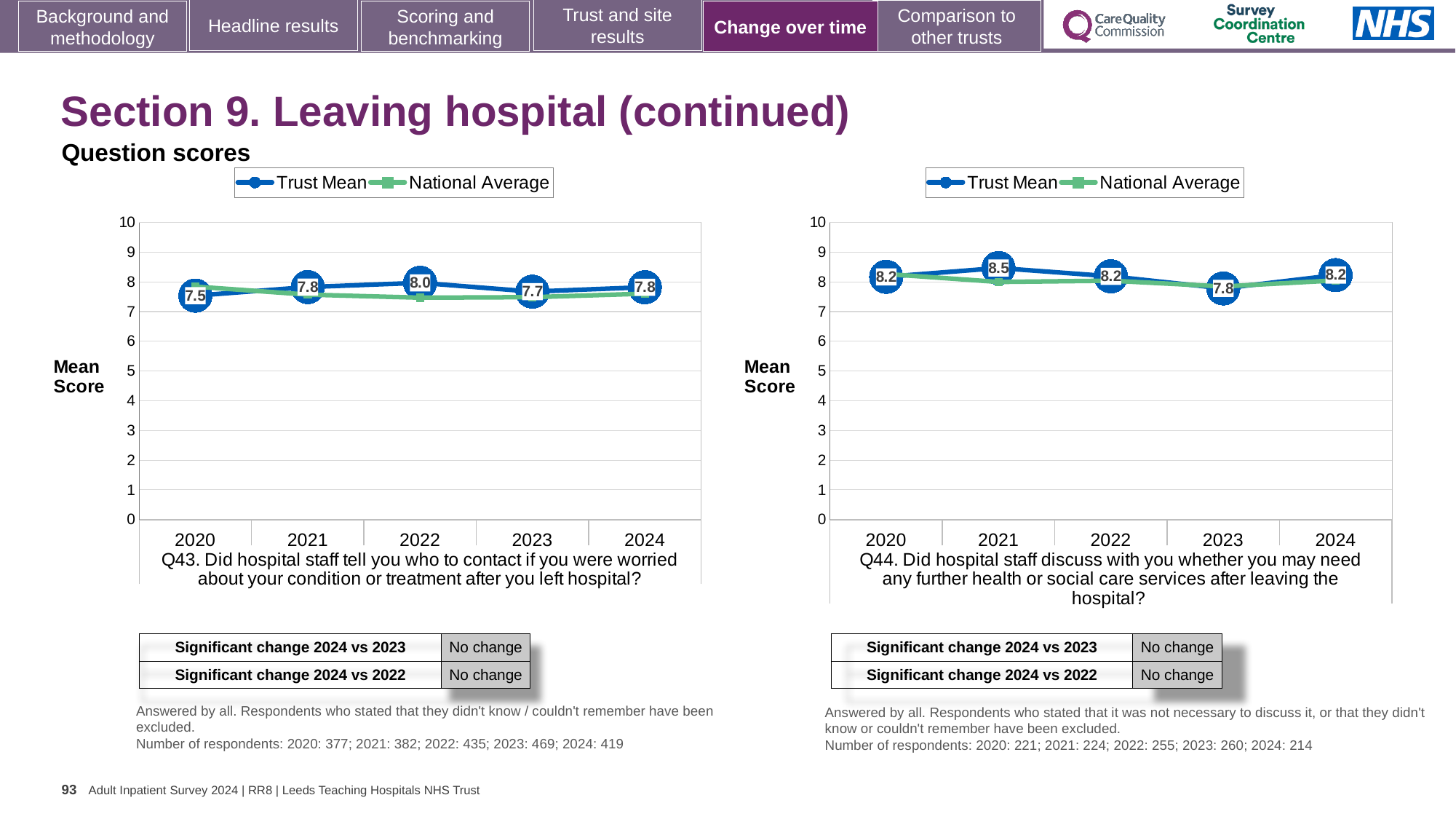
How many years are shown on the x axis of the Q43 chart (left)? 5 In the Q43 chart (left), what is the Trust Mean score for 2022? 8.0 In the Q44 chart (right), what is the Trust Mean score for 2021? 8.5 In the Q43 chart (left), which year has the highest Trust Mean score? 2022 What type of chart is used for the Q43 chart (left)? Line chart In the Q43 chart (left), is the Trust Mean score higher in 2021 or in 2023? 2021 How many series does the legend of the Q44 chart (right) list? 2 In the Q44 chart (right), is the National Average for 2021 greater or less than 9? less In the Q43 chart (left), what is the Trust Mean score for 2020? 7.5 In the Q44 chart (right), which year has the lowest Trust Mean score? 2023 In the Q44 chart (right), what is the difference between the Trust Mean scores for 2021 and 2023? 0.7 In the Q44 chart (right), what is the Trust Mean score for 2023? 7.8